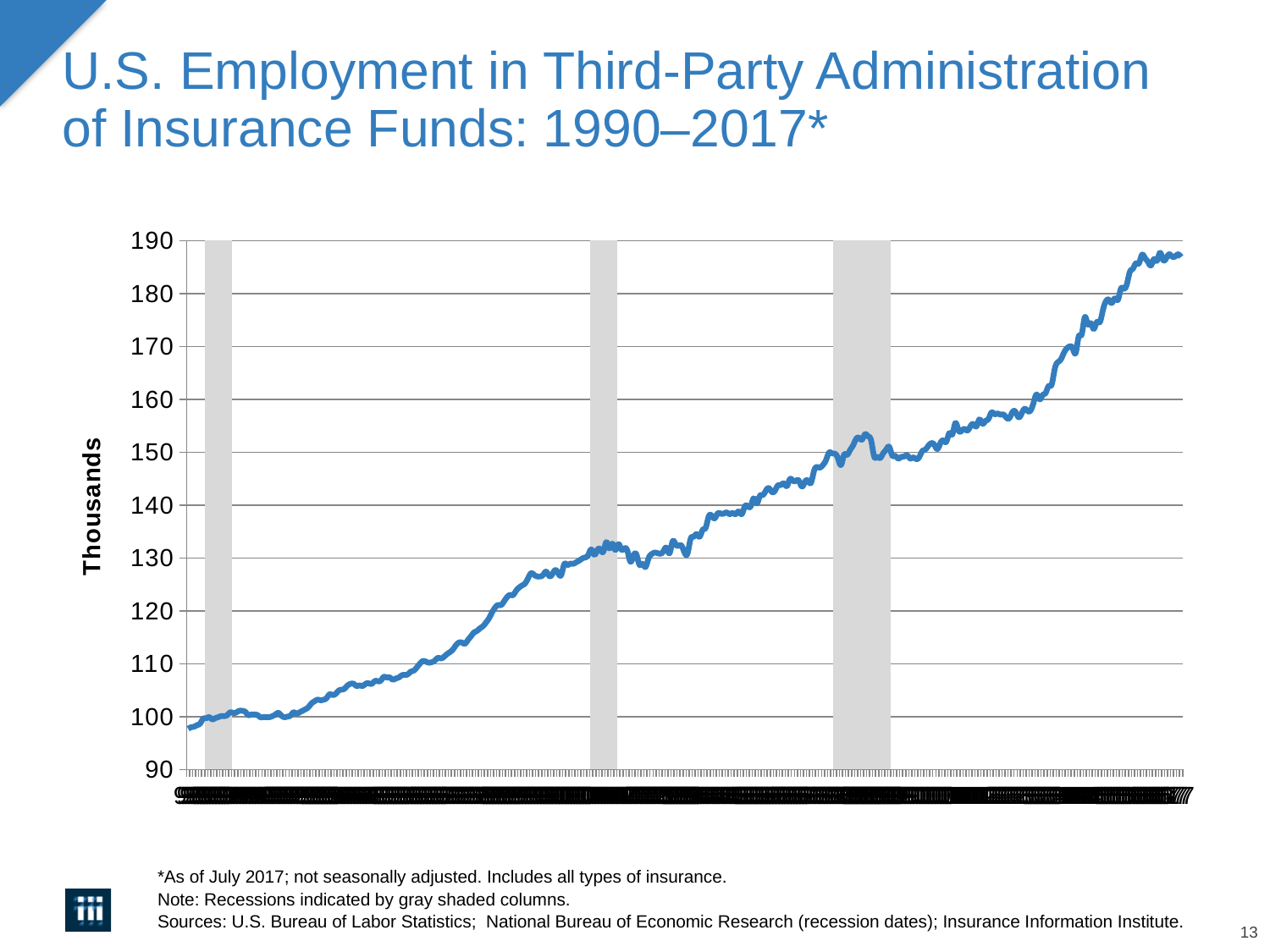
What is the label on the vertical axis? Thousands Where along the series does the line reach its highest value? at the end (2017) Overall, does employment in third-party administration of insurance funds rise or fall from 1990 to 2017? rise How many gray shaded recession columns are shown on the chart? 3 Is the value at the start of the series (1990) greater or less than 110? less Is the highest point of the line greater or less than 180? greater Is the value at the end of the series (2017) greater or less than 190? less What kind of chart is shown on the slide? line chart Which is larger, the value at the start of the series (1990) or the value at the end of the series (2017)? the end of the series (2017) Where along the series does the line reach its lowest value? at the start (1990)